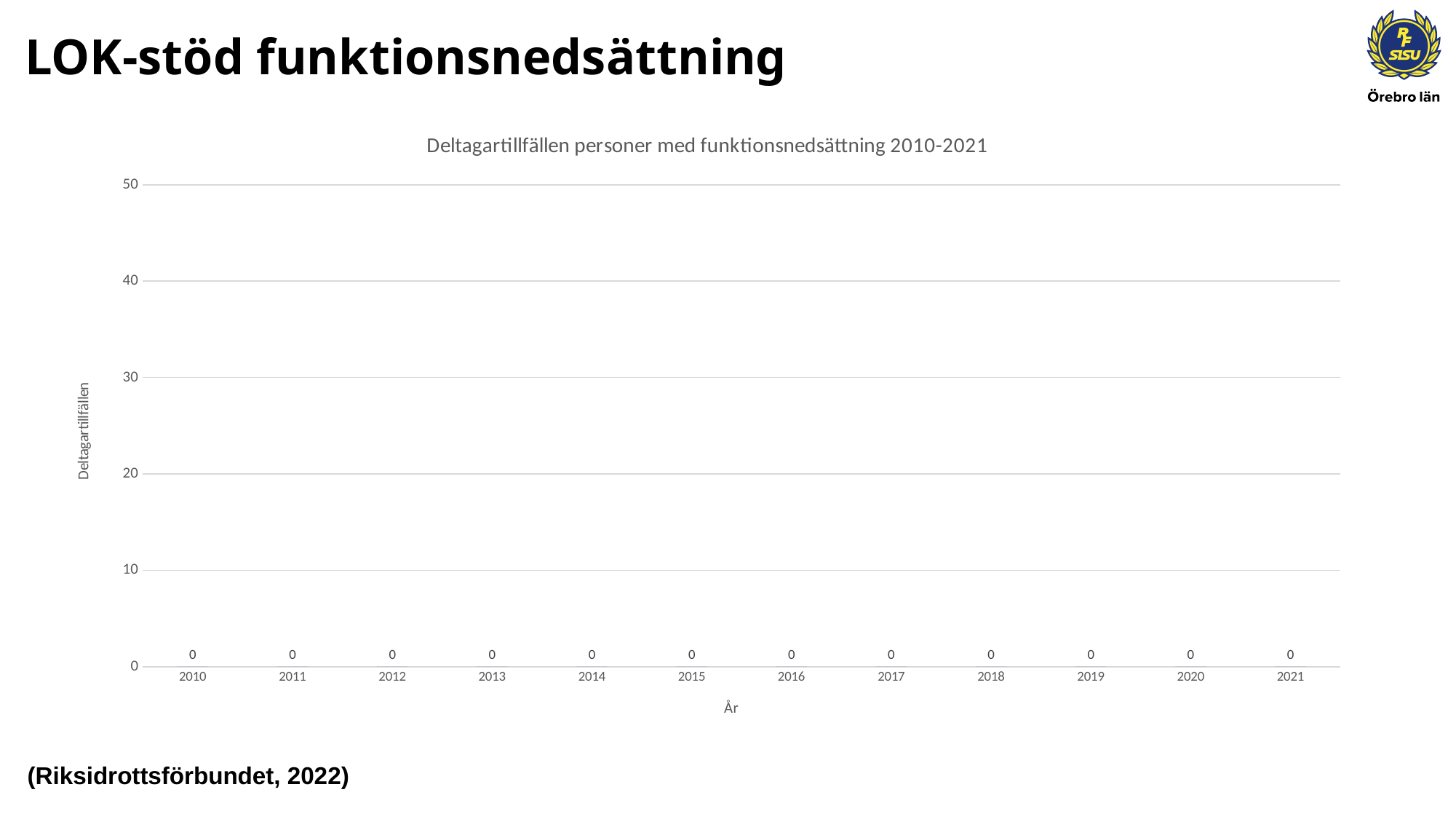
What is the value for 2010? 0 What is the difference between the values for 2012 and 2019? 0 What is the label of the x axis? År What is the value for 2015? 0 What is the value for 2018? 0 What is the title of the chart? Deltagartillfällen personer med funktionsnedsättning 2010-2021 Do the values rise, fall or stay the same from 2010 to 2021? stay the same What is the value for 2021? 0 Is the value for 2020 greater or less than 20? less How many years are shown on the x axis? 12 Is the value for 2014 greater or less than 10? less What is the highest value shown on the y axis? 50